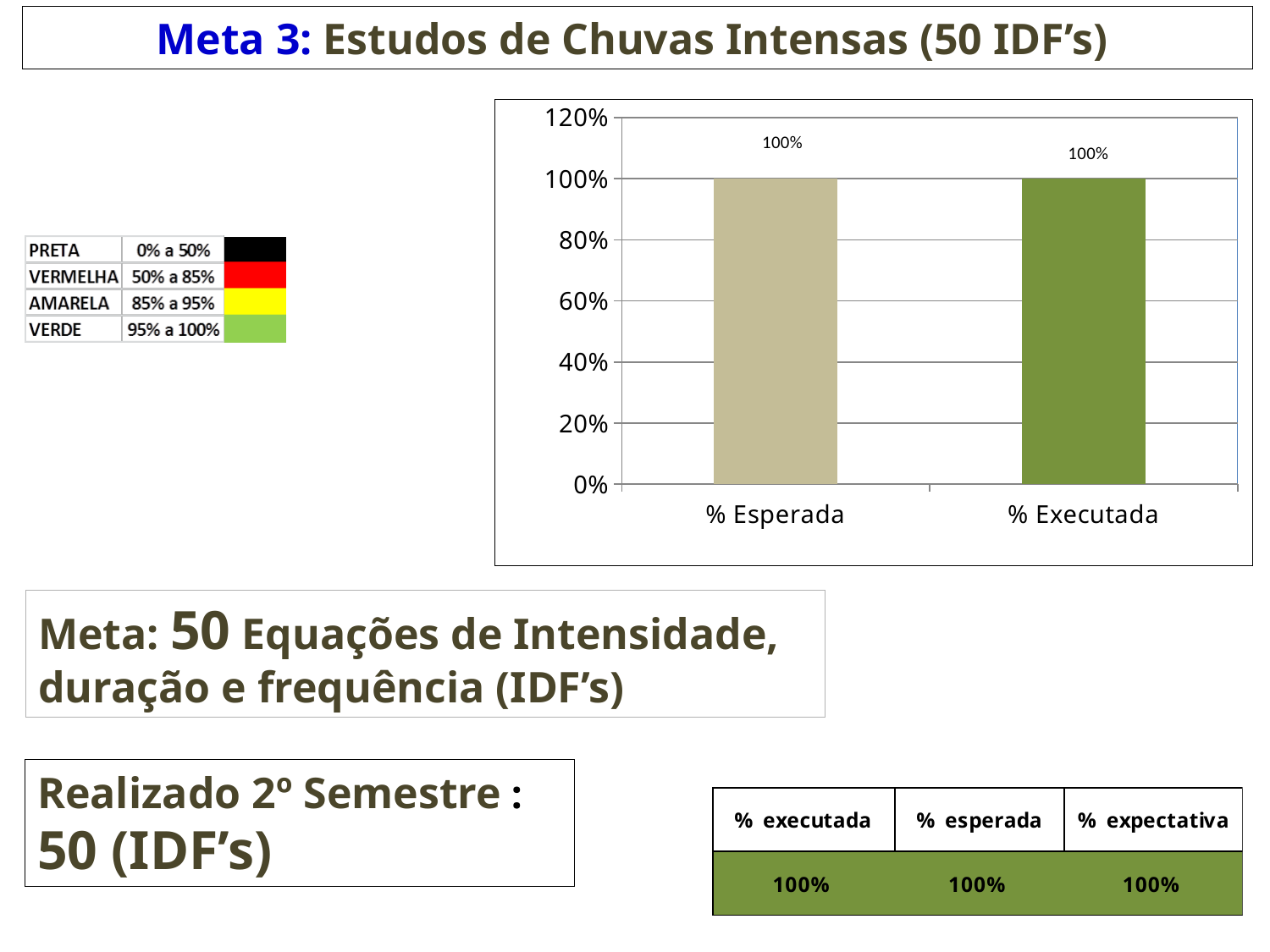
What is the difference between the values for % Esperada and % Executada? 0% Is the value for % Executada greater or less than 80%? greater What is the highest value shown on the vertical axis? 120% What is the value for % Esperada? 100% What kind of chart is shown on the slide? bar chart What is the label of the bar on the right of the chart? % Executada How many bars are plotted in the chart? 2 Is the value for % Esperada greater or less than 120%? less What is the value for % Executada? 100%